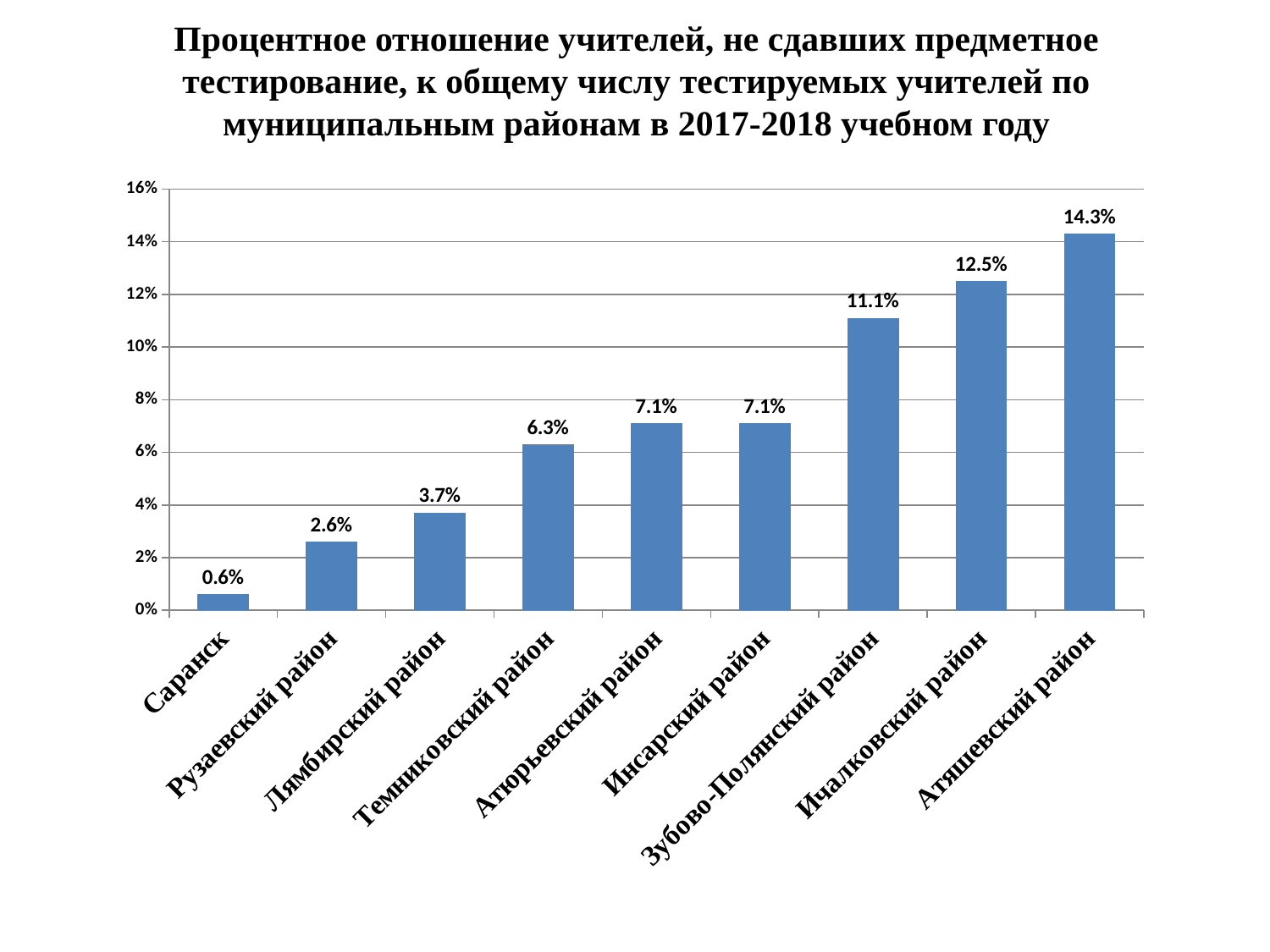
Which district has the highest value? Атяшевский район Do the values generally rise or fall from left to right along the x axis? rise What is the difference between the values for Атяшевский район and Ичалковский район? 1.8% Which is larger, the value for Ичалковский район or the value for Зубово-Полянский район? Ичалковский район How many districts are shown on the chart? 9 What kind of chart is shown on the slide? bar chart What is the value for Темниковский район? 6.3% What is the difference between the values for Лямбирский район and Рузаевский район? 1.1% What is the value for Саранск? 0.6% Which category has the lowest value? Саранск Is the value for Атюрьевский район greater or less than 8%? less What is the value for Зубово-Полянский район? 11.1%